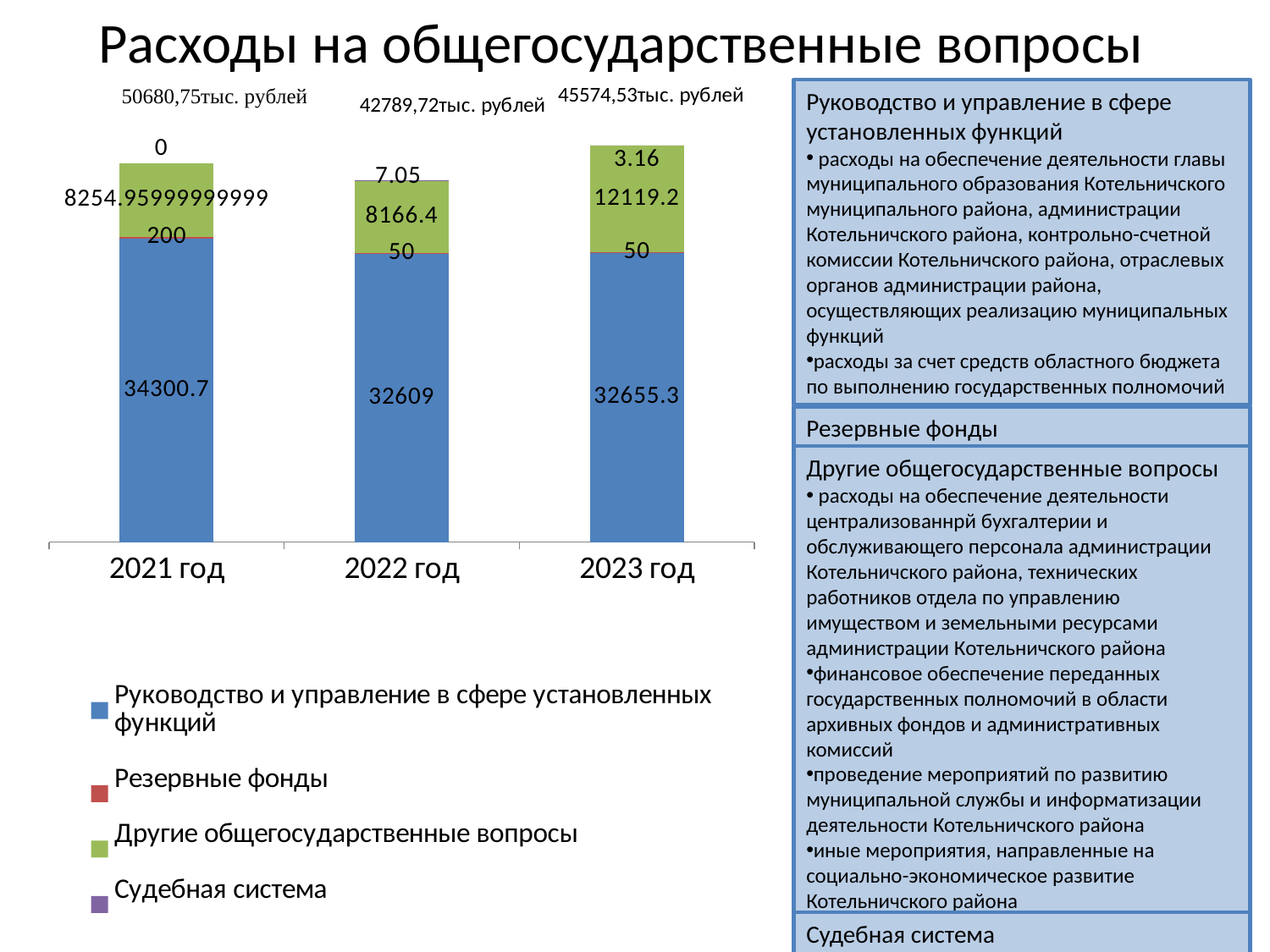
In which year is the value for Другие общегосударственные вопросы the highest? 2023 год By how much does the value for Другие общегосударственные вопросы in 2023 год exceed that in 2022 год? 3952.8 In which year is the value for Руководство и управление в сфере установленных функций the lowest? 2022 год How many series does the chart legend list? 4 Which year has the larger value for Резервные фонды, 2021 год or 2022 год? 2021 год What is the value for Другие общегосударственные вопросы in 2023 год? 12119.2 What is the value for Руководство и управление в сфере установленных функций in 2021 год? 34300.7 What is the value for Резервные фонды in 2022 год? 50 What is the value for Судебная система in 2022 год? 7.05 How many years (categories) are shown on the x axis of the chart? 3 What colour represents Судебная система in the chart legend? purple What kind of chart is shown on the slide? bar chart